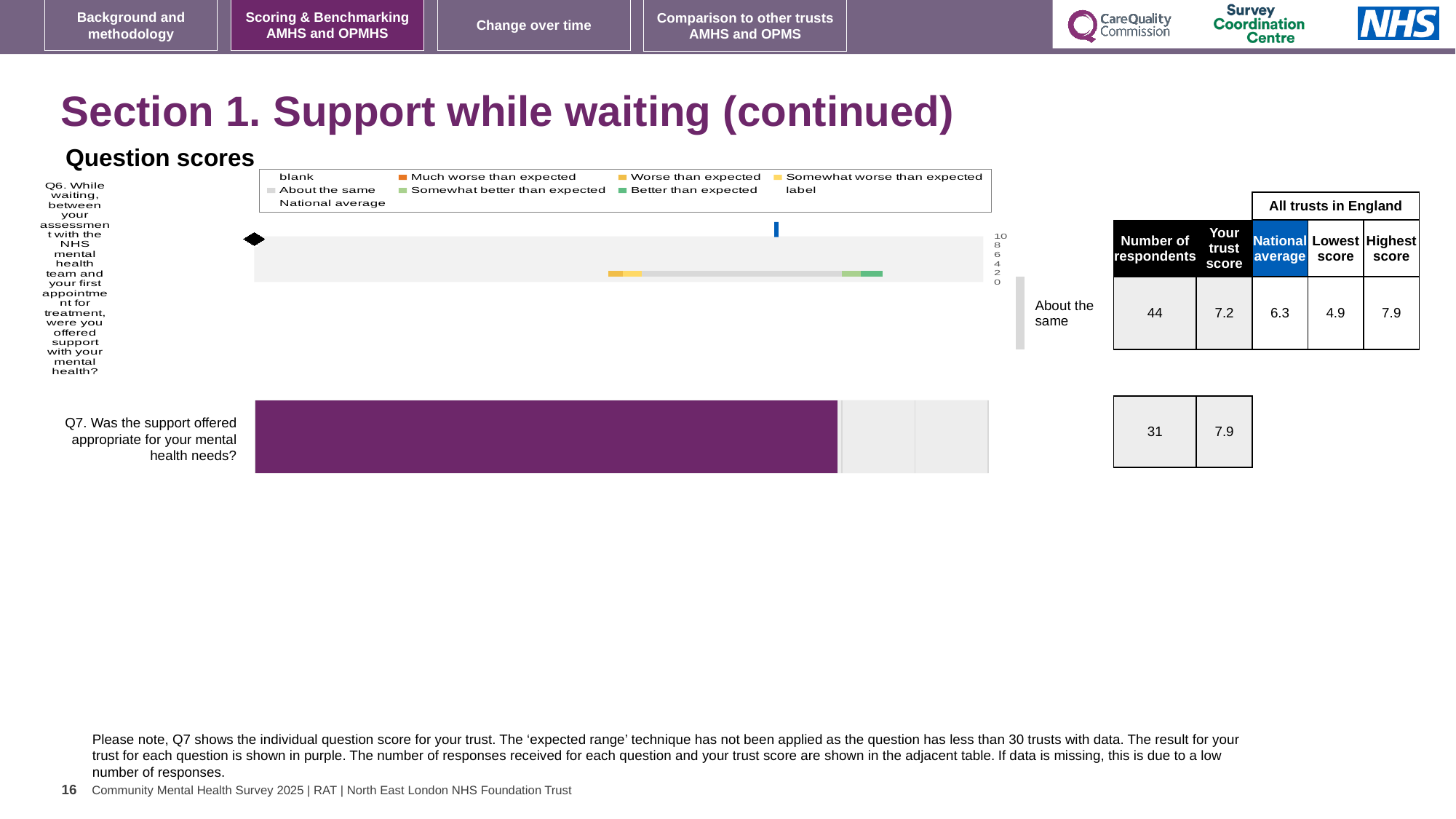
How many respondents answered Q7? 31 Which expected-range category is Q6 placed in, according to the label beside the chart? About the same What is the lowest score among all trusts in England for Q6? 4.9 What is the national average for Q6? 6.3 What is the trust score for Q6 shown in the table next to the chart? 7.2 How many questions are plotted in the chart? 2 What is the difference between the trust score and the national average for Q6? 0.9 What is the trust score for Q7? 7.9 How many more respondents answered Q6 than Q7? 13 What kind of chart is shown under 'Question scores'? bar chart What is the highest score among all trusts in England for Q6? 7.9 Which is larger for Q6, the trust score or the national average? trust score